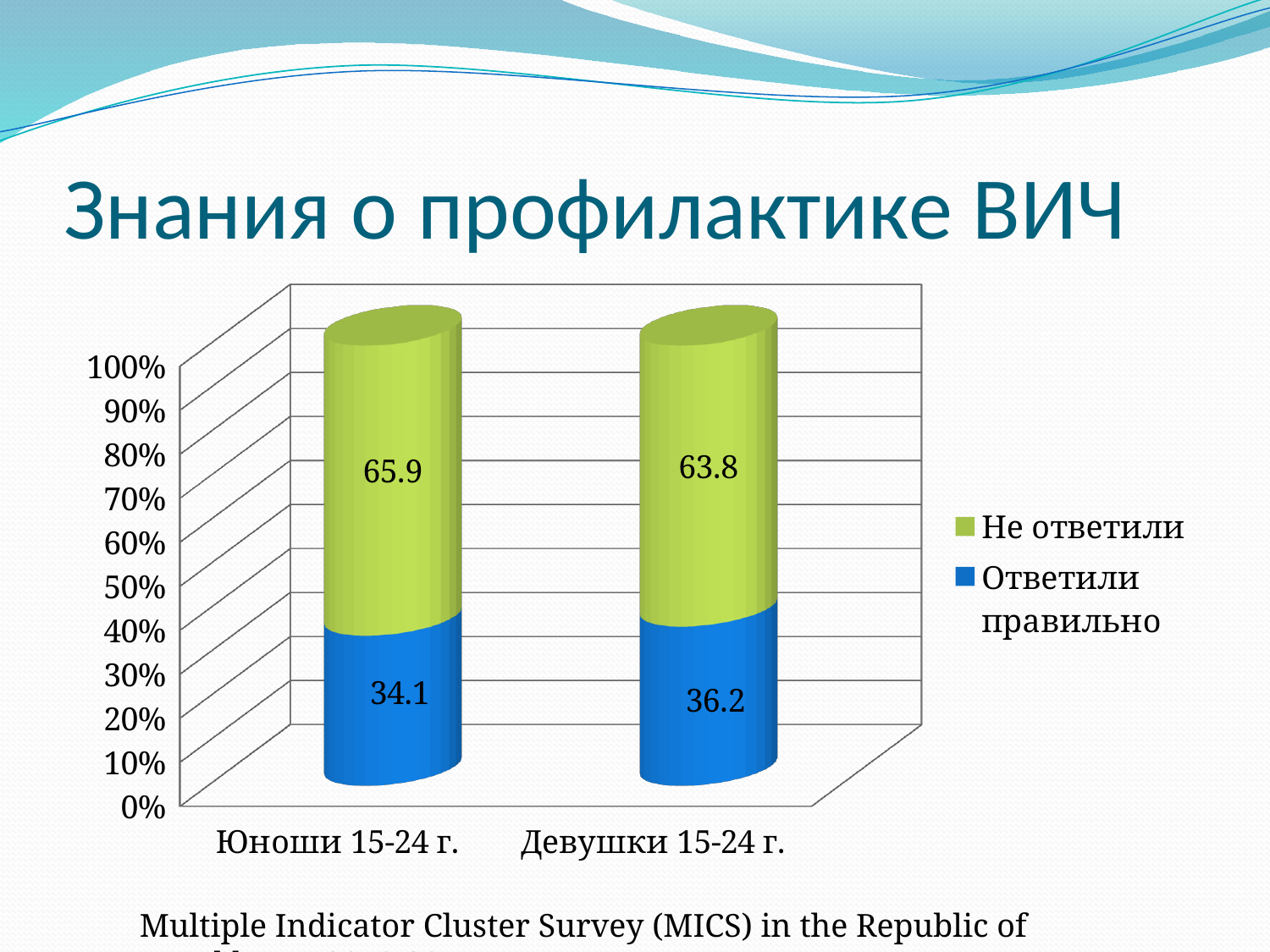
Which category has the lower value for "Не ответили"? Девушки 15-24 г. Which category has the higher value for "Ответили правильно"? Девушки 15-24 г. How many categories are shown on the x axis? 2 What is the value of "Не ответили" for "Девушки 15-24 г."? 63.8 What is the difference between the "Не ответили" values for "Юноши 15-24 г." and "Девушки 15-24 г."? 2.1 Which is larger: "Ответили правильно" for "Юноши 15-24 г." or "Ответили правильно" for "Девушки 15-24 г."? Девушки 15-24 г. What is the total of the stacked bar for "Юноши 15-24 г."? 100 What is the value of "Ответили правильно" for "Девушки 15-24 г."? 36.2 What kind of chart is shown on the slide? Stacked bar chart How many series does the legend list? 2 What is the value of "Ответили правильно" for "Юноши 15-24 г."? 34.1 What is the value of "Не ответили" for "Юноши 15-24 г."? 65.9